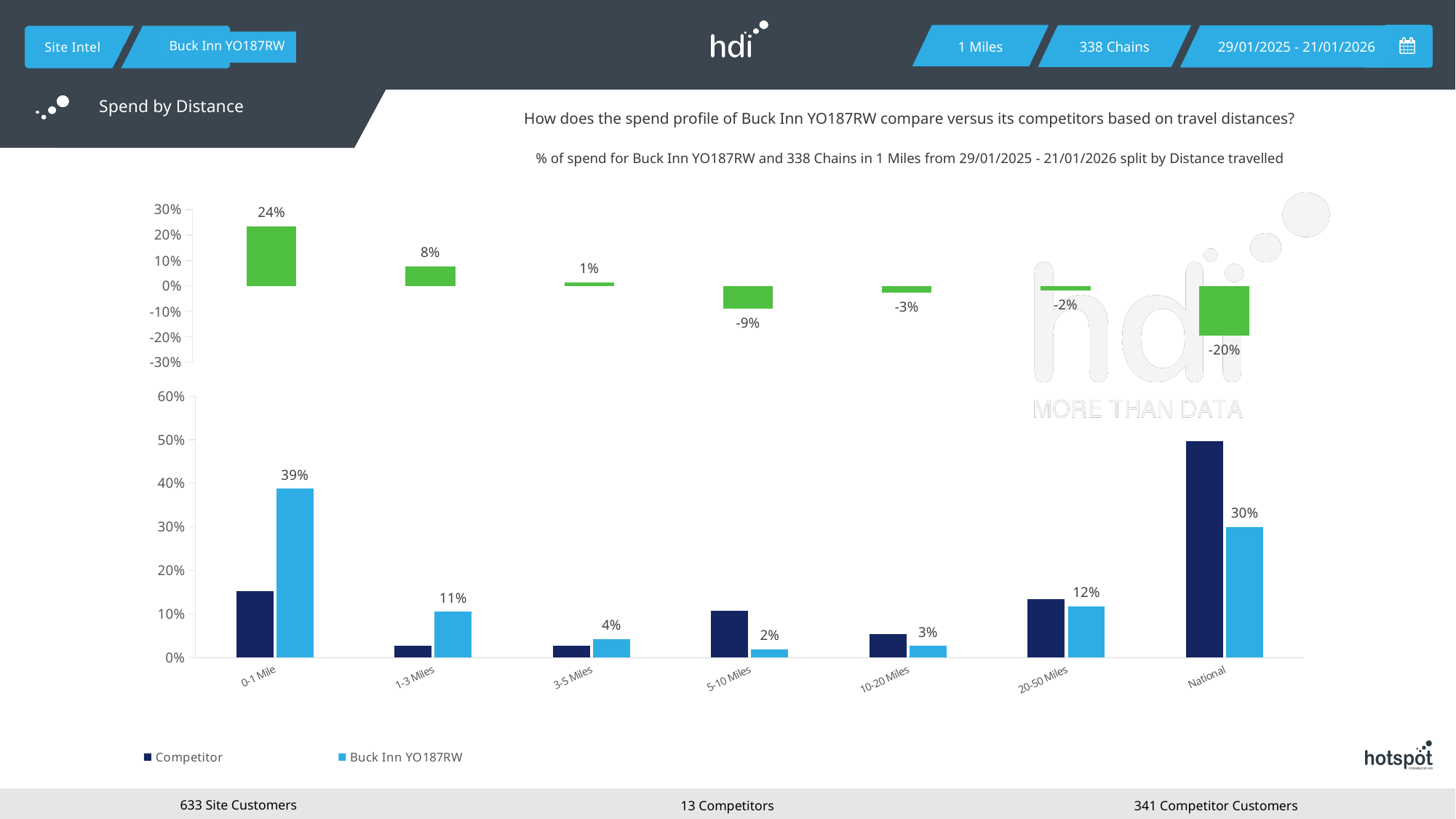
In the bottom chart, which is larger at 5-10 Miles: Competitor or Buck Inn YO187RW? Competitor In the bottom chart, what is the difference between the Buck Inn YO187RW values for 0-1 Mile and National? 9% In the bottom chart, what is the value for Buck Inn YO187RW at 20-50 Miles? 12% How many series does the legend of the bottom chart list? 2 In the top chart, what is the value for 0-1 Mile? 24% What kind of chart is the bottom chart? Bar chart In the bottom chart, what is the value for Buck Inn YO187RW at 0-1 Mile? 39% In the top chart, which category has the highest value? 0-1 Mile In the top chart, what is the value for National? -20% In the top chart, which category has the lowest value? National In the bottom chart, is the Competitor value for National greater or less than 40%? greater How many distance categories are shown on the x axis of the bottom chart? 7